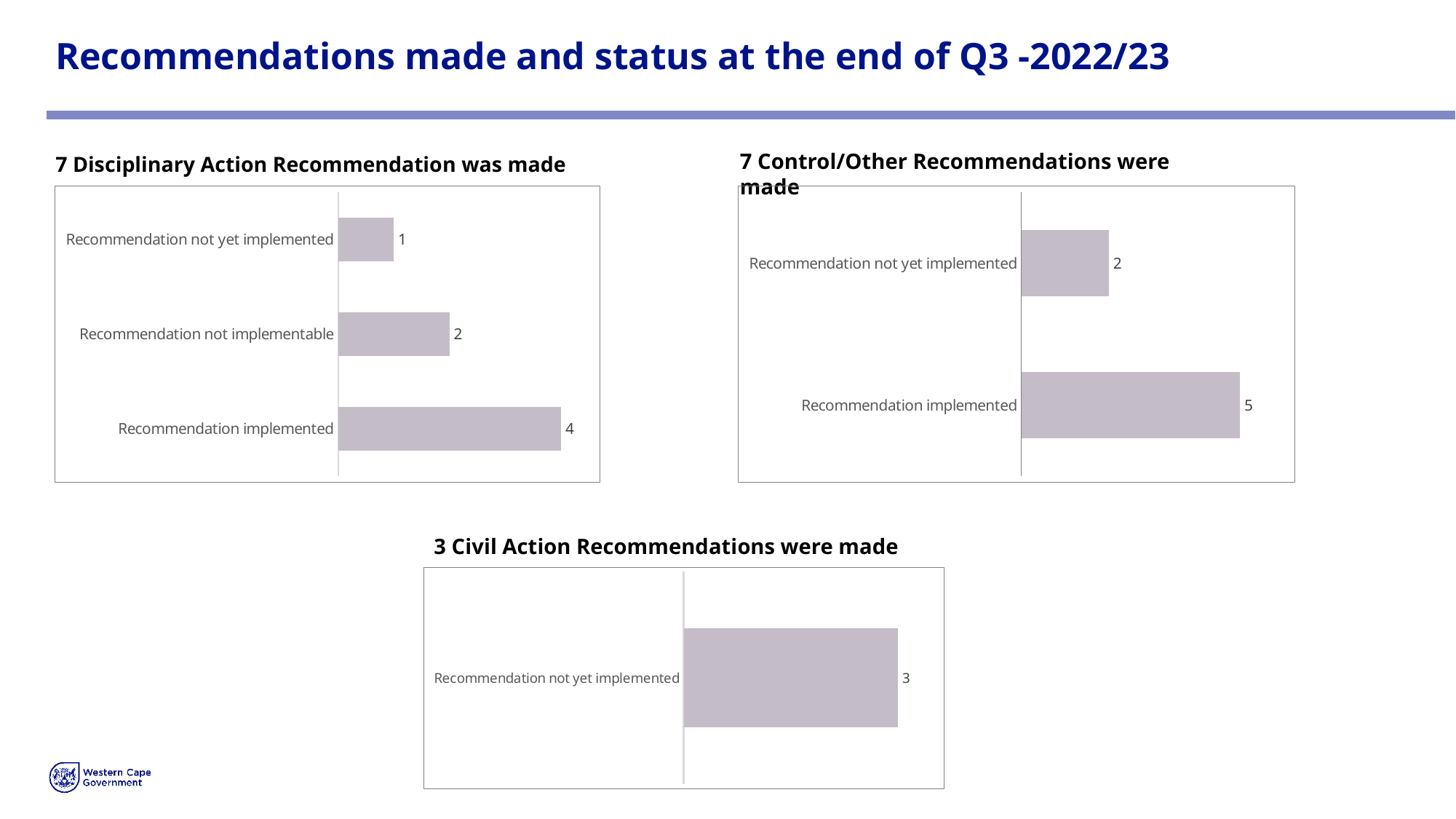
In the '7 Control/Other Recommendations were made' chart, what is the value for 'Recommendation not yet implemented'? 2 In the '3 Civil Action Recommendations were made' chart, what is the value for 'Recommendation not yet implemented'? 3 In the '7 Control/Other Recommendations were made' chart, which category has the highest value? Recommendation implemented In the '7 Disciplinary Action Recommendation was made' chart, what is the value for 'Recommendation not implementable'? 2 In the '7 Disciplinary Action Recommendation was made' chart, how many categories are shown? 3 In the '7 Disciplinary Action Recommendation was made' chart, which category has the lowest value? Recommendation not yet implemented In the '3 Civil Action Recommendations were made' chart, how many categories are shown? 1 In the '7 Control/Other Recommendations were made' chart, what is the value for 'Recommendation implemented'? 5 In the '7 Control/Other Recommendations were made' chart, what is the difference between 'Recommendation implemented' and 'Recommendation not yet implemented'? 3 In the '7 Disciplinary Action Recommendation was made' chart, what is the value for 'Recommendation implemented'? 4 What type of chart is the '7 Disciplinary Action Recommendation was made' chart? Bar chart In the '7 Disciplinary Action Recommendation was made' chart, what is the difference between 'Recommendation implemented' and 'Recommendation not yet implemented'? 3